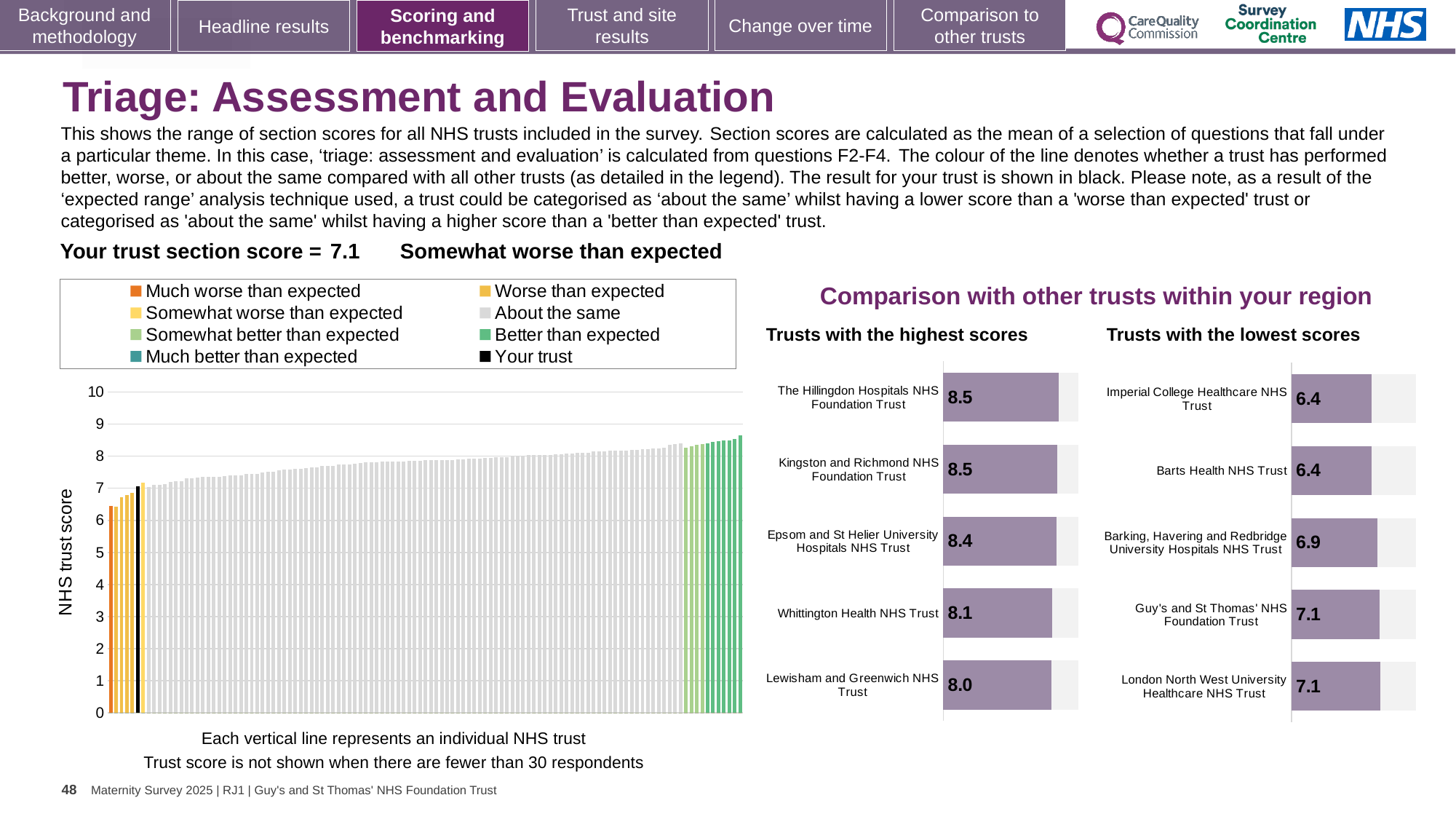
In the 'Trusts with the highest scores' chart, what is the score for Whittington Health NHS Trust? 8.1 What kind of chart is the main chart on the left showing NHS trust scores? bar chart In the main 'NHS trust score' chart, do the bars rise or fall from left to right? rise In the 'Trusts with the highest scores' chart, which has the higher score: Epsom and St Helier University Hospitals NHS Trust or Whittington Health NHS Trust? Epsom and St Helier University Hospitals NHS Trust In the 'Trusts with the highest scores' chart, which trust has the lowest score? Lewisham and Greenwich NHS Trust How many entries does the legend of the main 'NHS trust score' chart list? 8 In the 'Trusts with the highest scores' chart, what is the difference between the scores of The Hillingdon Hospitals NHS Foundation Trust and Lewisham and Greenwich NHS Trust? 0.5 In the 'Trusts with the lowest scores' chart, what is the score for Barking, Havering and Redbridge University Hospitals NHS Trust? 6.9 In the main 'NHS trust score' chart, is the value of the tallest bar greater or less than 8? greater What is the label on the vertical axis of the main chart on the left? NHS trust score How many trusts are listed in the 'Trusts with the highest scores' chart? 5 In the 'Trusts with the lowest scores' chart, what is the difference between the scores of London North West University Healthcare NHS Trust and Imperial College Healthcare NHS Trust? 0.7